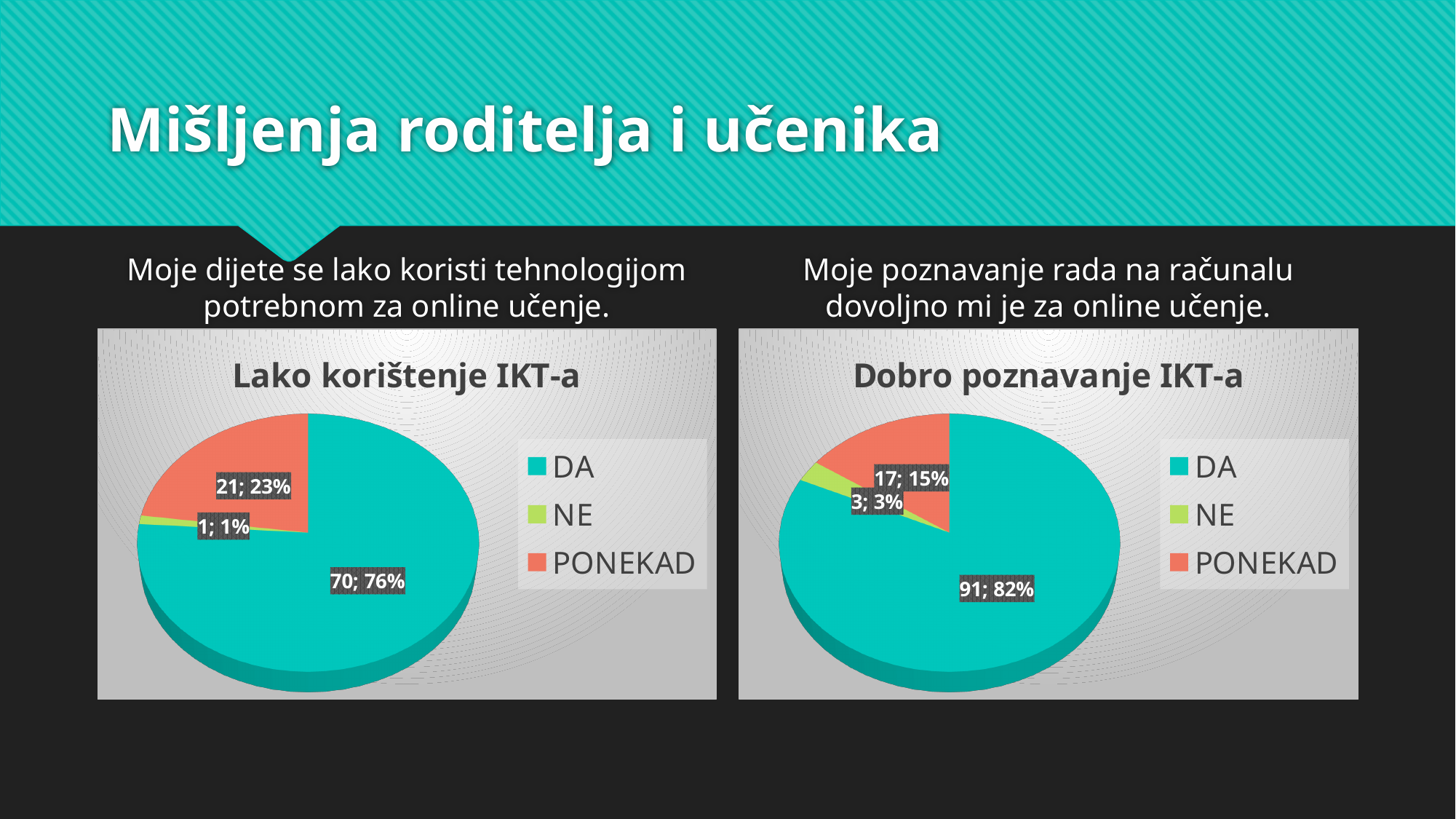
In the 'Dobro poznavanje IKT-a' chart, what is the value and share for NE? 3; 3% How many categories does the legend of the 'Dobro poznavanje IKT-a' chart list? 3 In the 'Lako korištenje IKT-a' chart, what is the value and share for DA? 70; 76% In the 'Lako korištenje IKT-a' chart, what is the difference between the DA count and the PONEKAD count? 49 In the 'Dobro poznavanje IKT-a' chart, what is the value and share for DA? 91; 82% In the 'Lako korištenje IKT-a' chart, which category has the smallest slice? NE In the 'Dobro poznavanje IKT-a' chart, which is larger, PONEKAD or NE? PONEKAD What type of chart is 'Lako korištenje IKT-a'? Pie chart In the 'Dobro poznavanje IKT-a' chart, what is the difference between the PONEKAD count and the NE count? 14 In the 'Lako korištenje IKT-a' chart, what is the value and share for PONEKAD? 21; 23% In the 'Lako korištenje IKT-a' chart, what share of the pie does PONEKAD take? 23% In the 'Dobro poznavanje IKT-a' chart, which category has the largest slice? DA